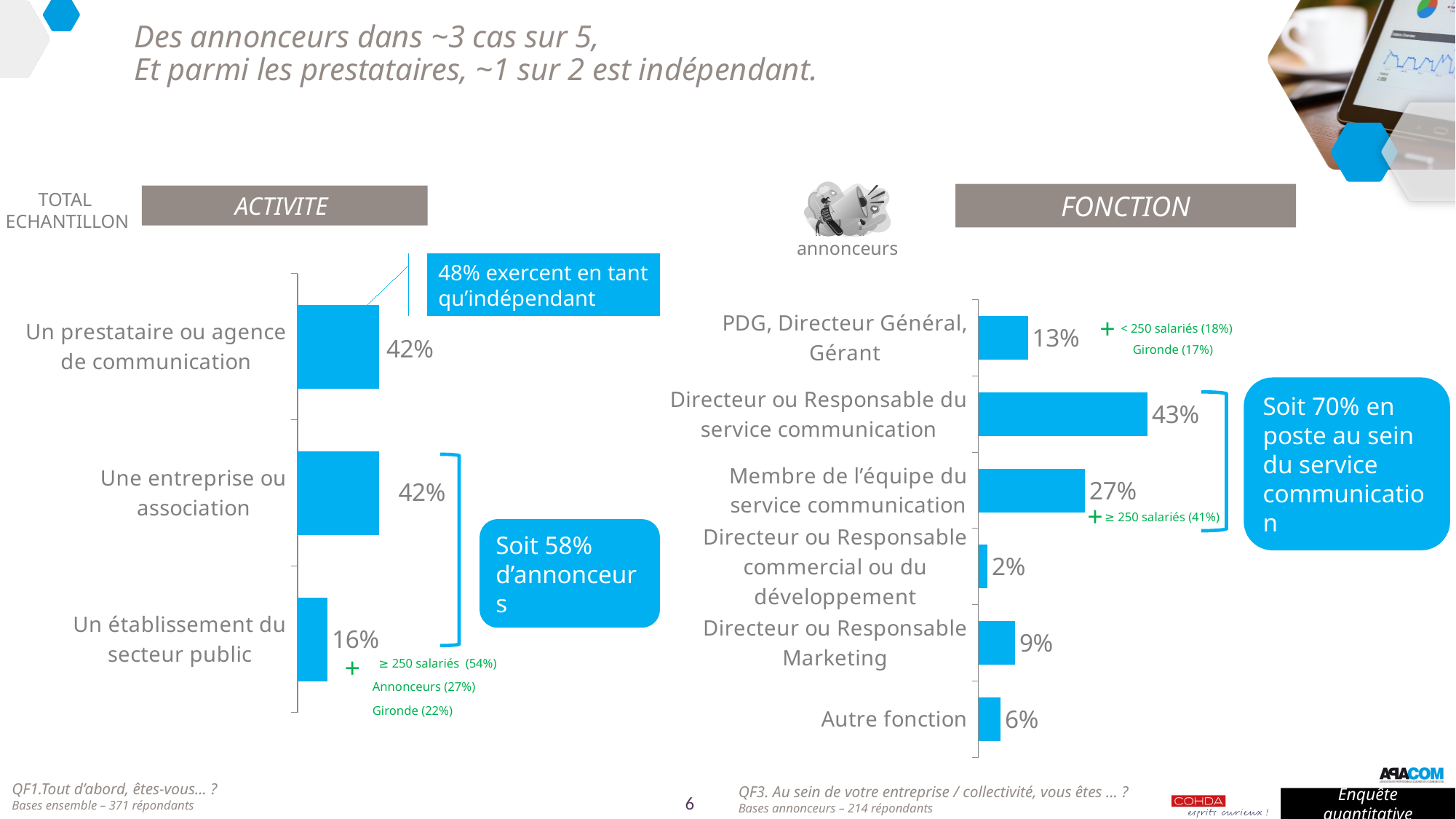
In the FONCTION chart, what is the value for "Directeur ou Responsable Marketing"? 9% In the ACTIVITE chart, how many categories are shown? 3 In the FONCTION chart, what is the value for "Directeur ou Responsable du service communication"? 43% In the FONCTION chart, how many categories are shown? 6 In the FONCTION chart, which category has the highest value? Directeur ou Responsable du service communication In the ACTIVITE chart, what is the difference between "Une entreprise ou association" and "Un établissement du secteur public"? 26% In the ACTIVITE chart, which category has the lowest value? Un établissement du secteur public In the FONCTION chart, which is larger: "PDG, Directeur Général, Gérant" or "Membre de l'équipe du service communication"? Membre de l'équipe du service communication In the FONCTION chart, which category has the lowest value? Directeur ou Responsable commercial ou du développement What type of chart is the FONCTION chart? Bar chart In the ACTIVITE chart, what is the value for "Une entreprise ou association"? 42% In the ACTIVITE chart, what is the value for "Un établissement du secteur public"? 16%